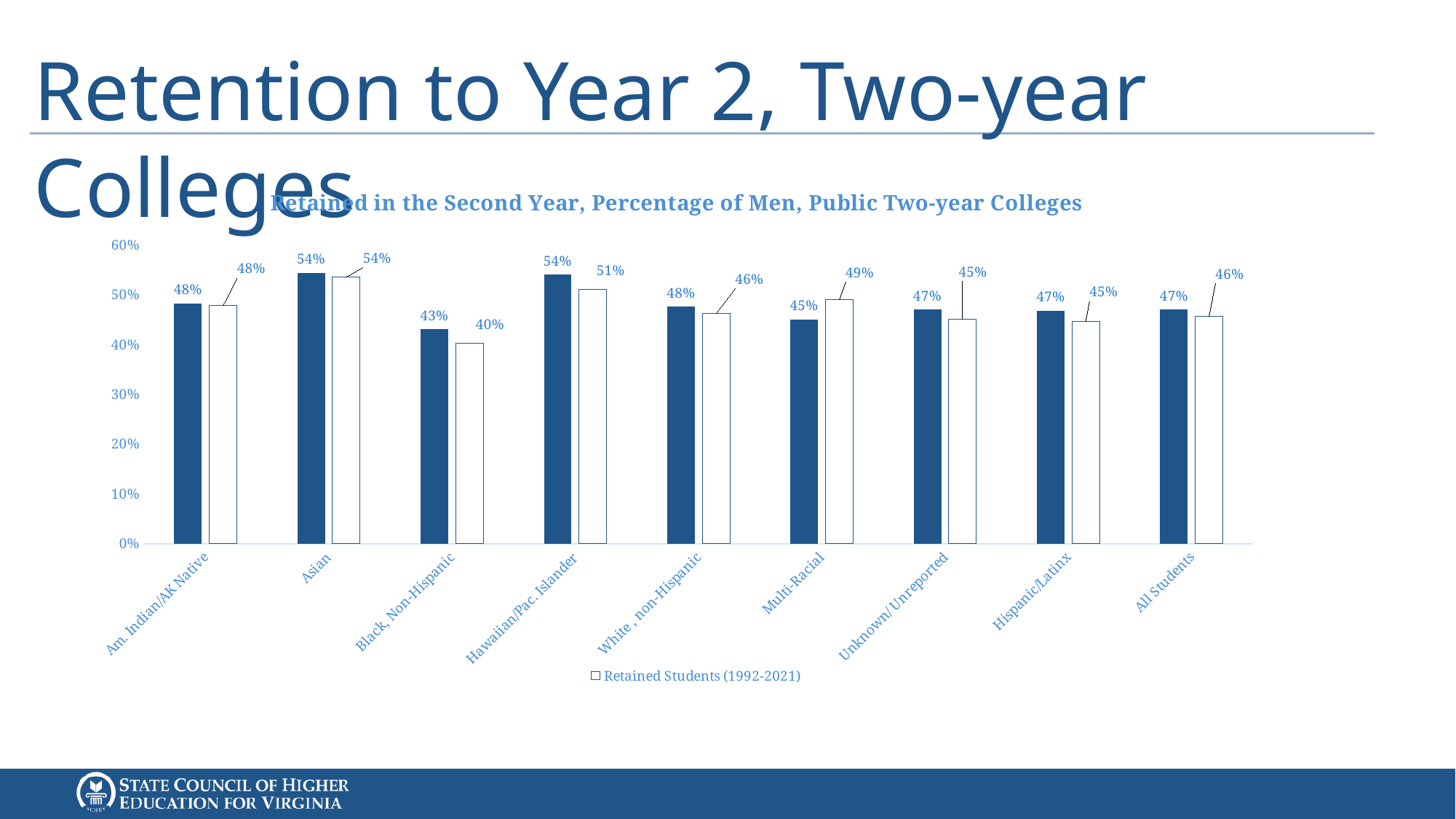
What is the title of the chart? Retained in the Second Year, Percentage of Men, Public Two-year Colleges Is the Retained Students (1992-2021) value for Hawaiian/Pac. Islander greater or less than 40%? greater Which category has the lowest Retained Students (1992-2021) value? Black, Non-Hispanic What is the difference between the solid dark blue bar and the Retained Students (1992-2021) bar for Black, Non-Hispanic? 3 percentage points What is the value of the Retained Students (1992-2021) bar for All Students? 46% What is the value of the solid dark blue bar for Multi-Racial? 45% What is the value of the Retained Students (1992-2021) bar for Black, Non-Hispanic? 40% Which category has the lowest solid dark blue bar value? Black, Non-Hispanic For Multi-Racial, which is larger: the solid dark blue bar or the Retained Students (1992-2021) bar? Retained Students (1992-2021) What type of chart is shown on the slide? Bar chart How many categories are shown on the x axis? 9 Which category has the highest Retained Students (1992-2021) value? Asian